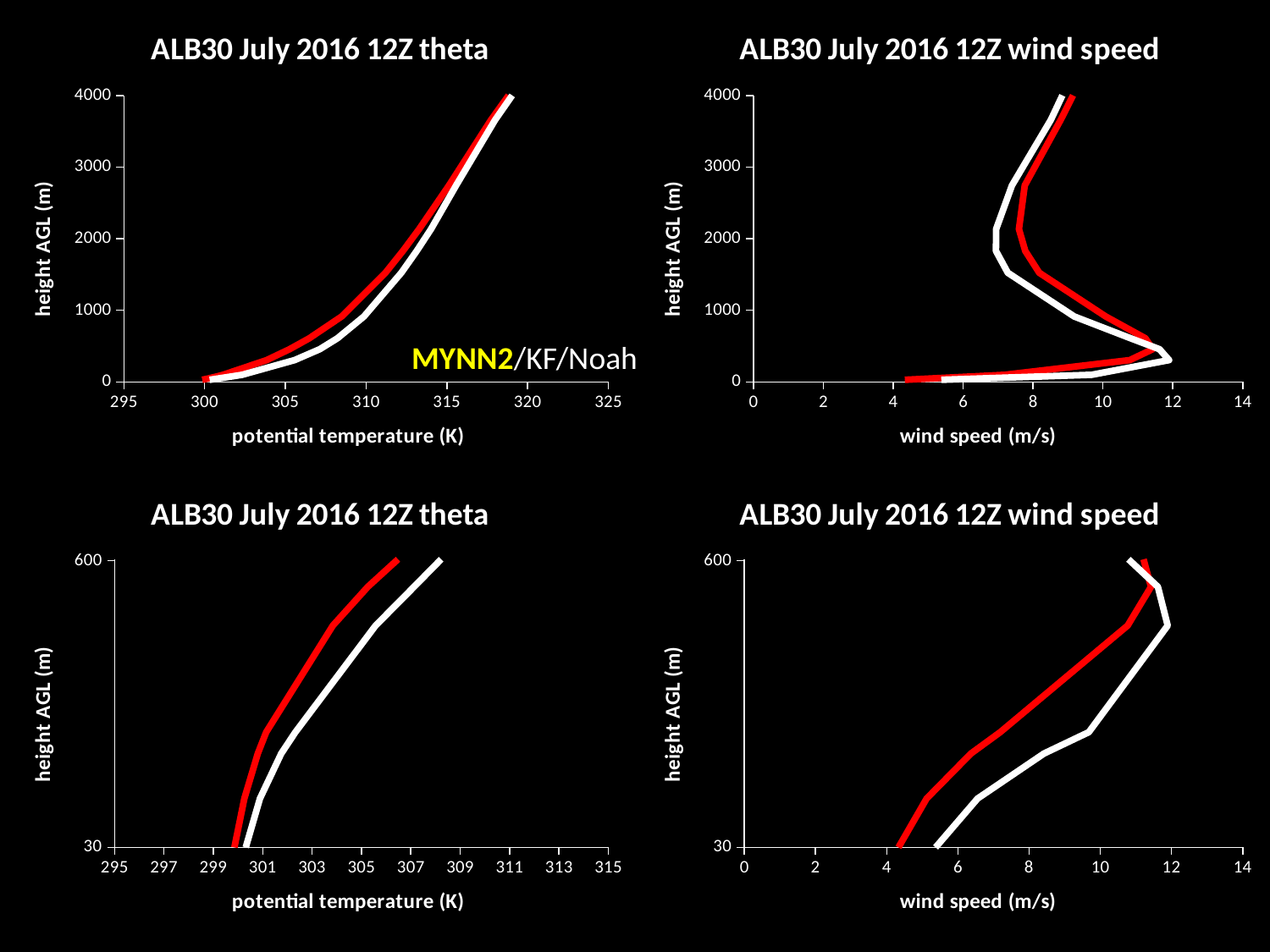
In the top-right chart 'ALB30 July 2016 12Z wind speed', what is the y-axis label? height AGL (m) In the bottom-left chart 'ALB30 July 2016 12Z theta', which line has the higher potential temperature at 600 m, the red or the white? white In the top-right chart 'ALB30 July 2016 12Z wind speed', is the red line's wind speed at 0 m greater or less than 6? less How many charts are shown on the slide? 4 In the bottom-right chart 'ALB30 July 2016 12Z wind speed', is the white line's wind speed at 30 m greater or less than 4? greater In the top-right chart 'ALB30 July 2016 12Z wind speed', is the peak wind speed of the white line greater or less than 10? greater In the bottom-right chart 'ALB30 July 2016 12Z wind speed', which line has the higher wind speed at 30 m, the red or the white? white What kind of chart is the top-left chart titled 'ALB30 July 2016 12Z theta'? line chart In the top-left chart 'ALB30 July 2016 12Z theta', does potential temperature rise or fall as height increases? rise In the top-left chart 'ALB30 July 2016 12Z theta', what is the x-axis label? potential temperature (K)